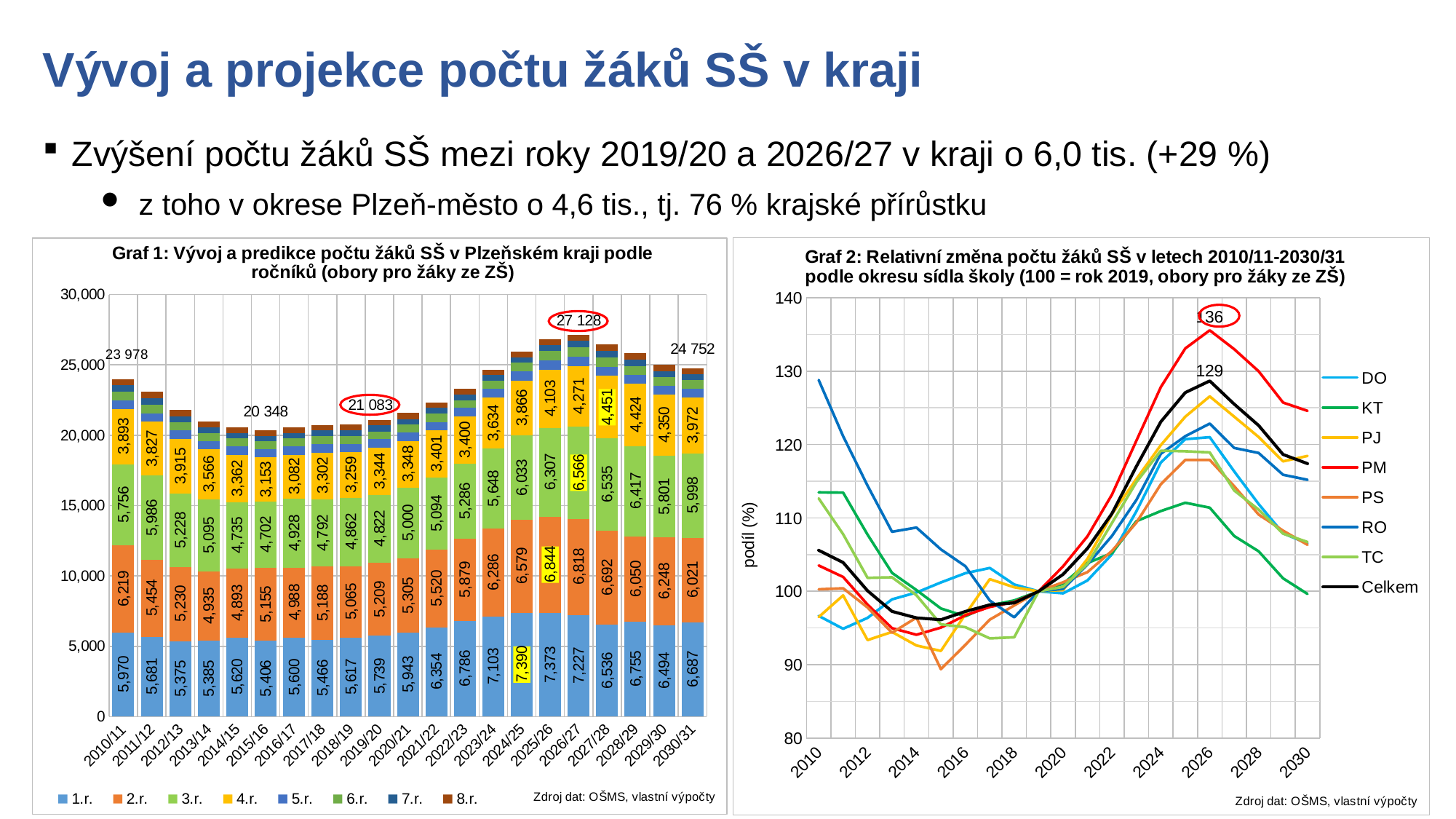
How many series does the legend of Graf 2 (the right chart) list? 8 How many school years (bars) are shown in Graf 1 (the left chart)? 21 In Graf 1 (the left chart), which year has the highest 4.r. value? 2027/28 In Graf 1 (the left chart), what is the total labelled above the 2026/27 bar? 27 128 In Graf 1 (the left chart), is the 3.r. value larger in 2026/27 or in 2019/20? 2026/27 In Graf 2 (the right chart), is the value for RO in 2010 greater or less than 120? greater How many series does the legend of Graf 1 (the left chart) list? 8 In Graf 1 (the left chart), what is the value for 2.r. in 2025/26? 6,844 In Graf 2 (the right chart), what is the labelled peak value of the PM line in 2026? 136 In Graf 1 (the left chart), what is the difference between the 1.r. value in 2030/31 and in 2010/11? 717 What kind of chart is Graf 1 (the left chart)? bar chart In Graf 1 (the left chart), what is the value for 1.r. in 2024/25? 7,390